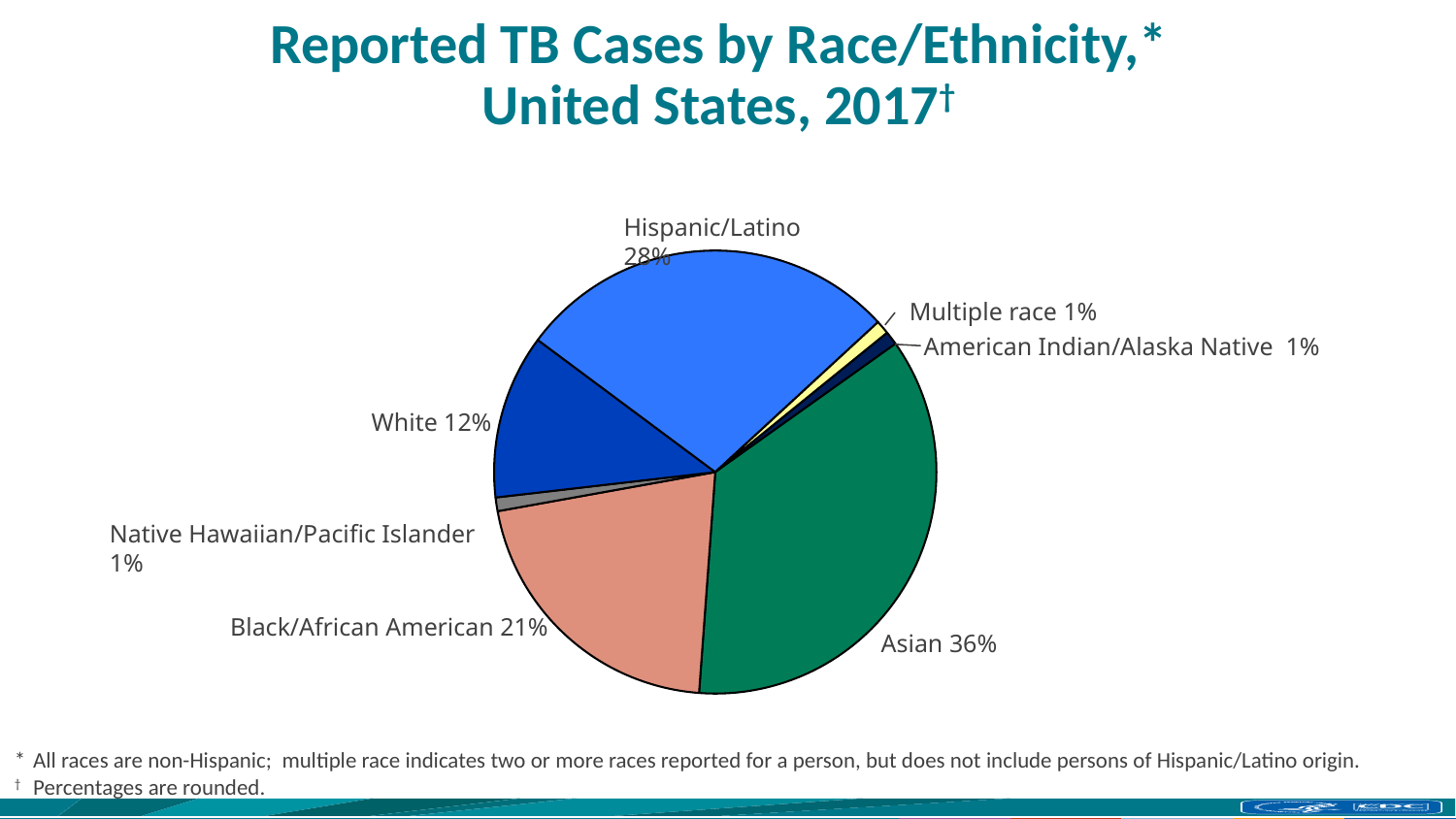
What percentage of reported TB cases is shown for White? 12% What percentage of reported TB cases is shown for Hispanic/Latino? 28% What is the difference in percentage points between the Asian and Hispanic/Latino shares? 8 What kind of chart is shown on the slide? Pie chart What percentage of reported TB cases is shown for Asian? 36% What is the difference in percentage points between the Black/African American and White shares? 9 Which group has a larger share of reported TB cases, Black/African American or White? Black/African American What percentage of reported TB cases is shown for Black/African American? 21% What is the title of the chart on the slide? Reported TB Cases by Race/Ethnicity, United States, 2017 How many slices does the pie chart have? 7 Which race/ethnicity group has the largest share of reported TB cases? Asian What percentage of reported TB cases is shown for Native Hawaiian/Pacific Islander? 1%